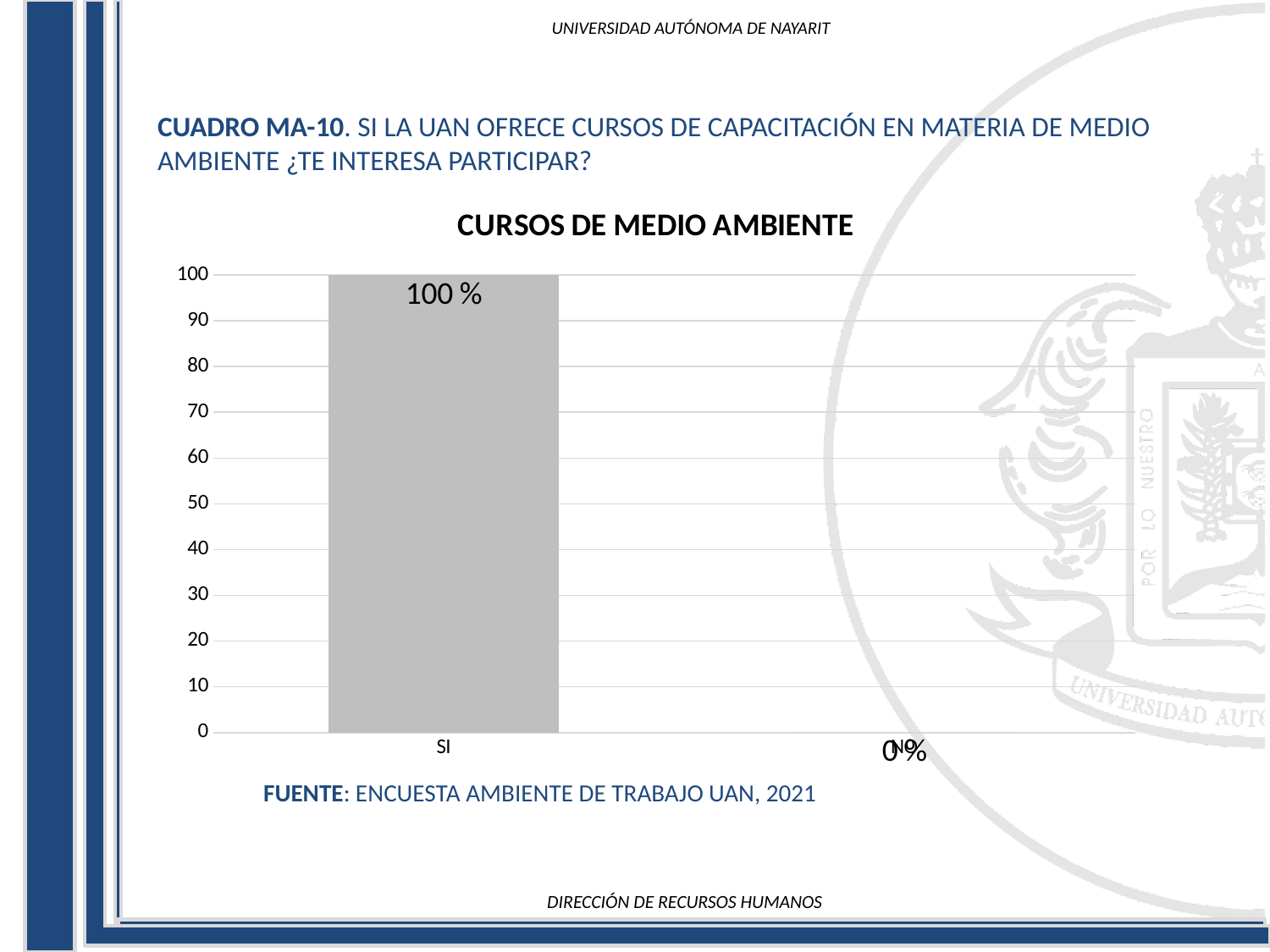
Which is larger, the value for SI or the value for NO? SI Which category has the lowest value? NO Which category has the highest value? SI What is the value shown for SI? 100 % What is the difference between the values for SI and NO? 100 % What is the title of the chart? CURSOS DE MEDIO AMBIENTE What kind of chart is shown? bar chart What is the value shown for NO? 0% How many categories are shown on the x axis? 2 What is the highest value shown on the y axis? 100 Is the value for SI greater or less than 50? greater